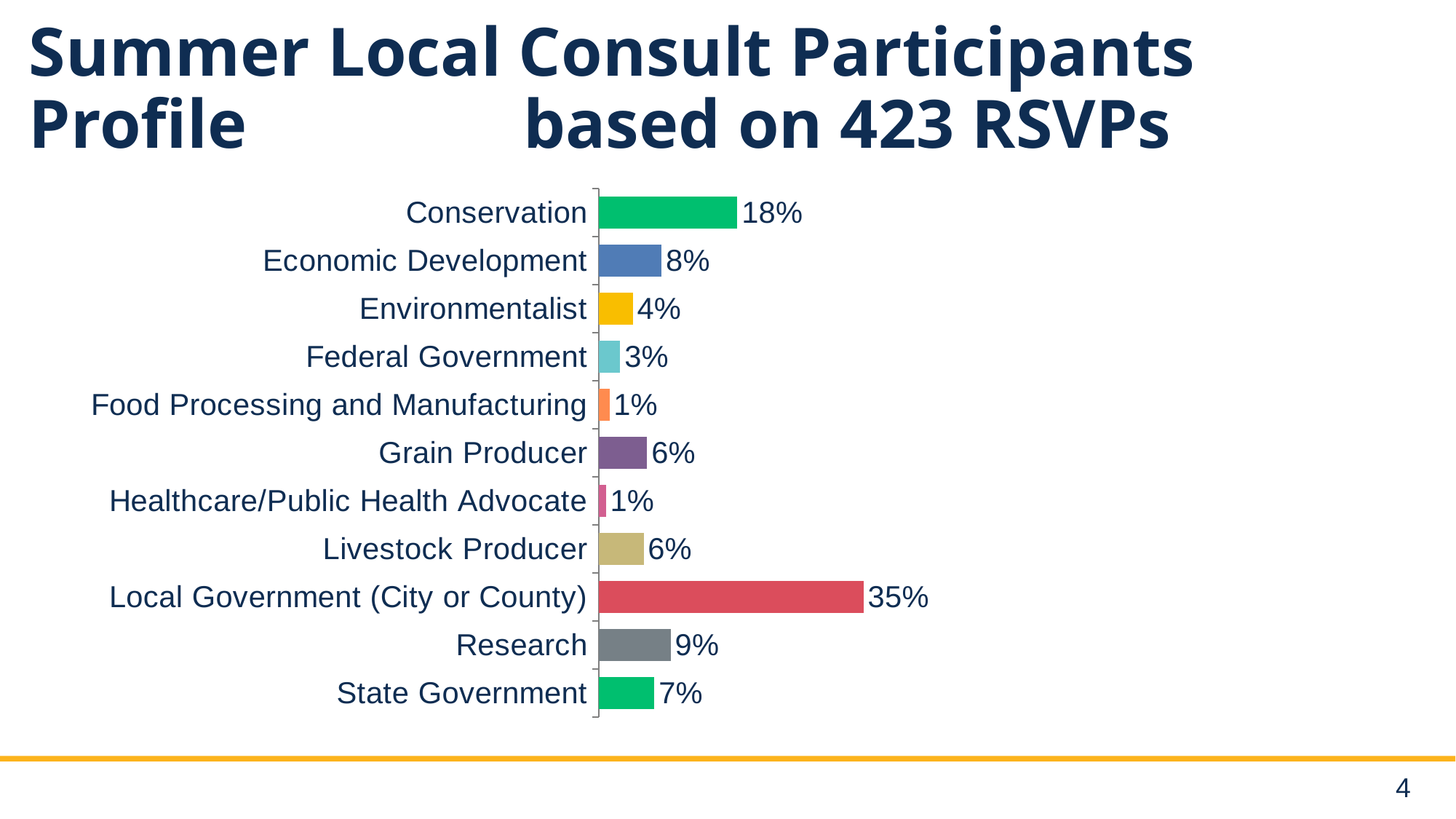
What is the value for Research? 9% Which is larger, Environmentalist or Federal Government? Environmentalist How many categories are shown in the chart? 11 Which category has the highest share of participants? Local Government (City or County) How many RSVPs is the participant profile based on, according to the slide title? 423 What is the value shown for Conservation? 18% What percentage of participants are Grain Producers? 6% What kind of chart is shown on the slide? Bar chart What is the difference between the Research value and the Economic Development value? 1% What is the difference between the Local Government (City or County) value and the Conservation value? 17% Which is larger, Economic Development or State Government? Economic Development What percentage of participants are from Local Government (City or County)? 35%